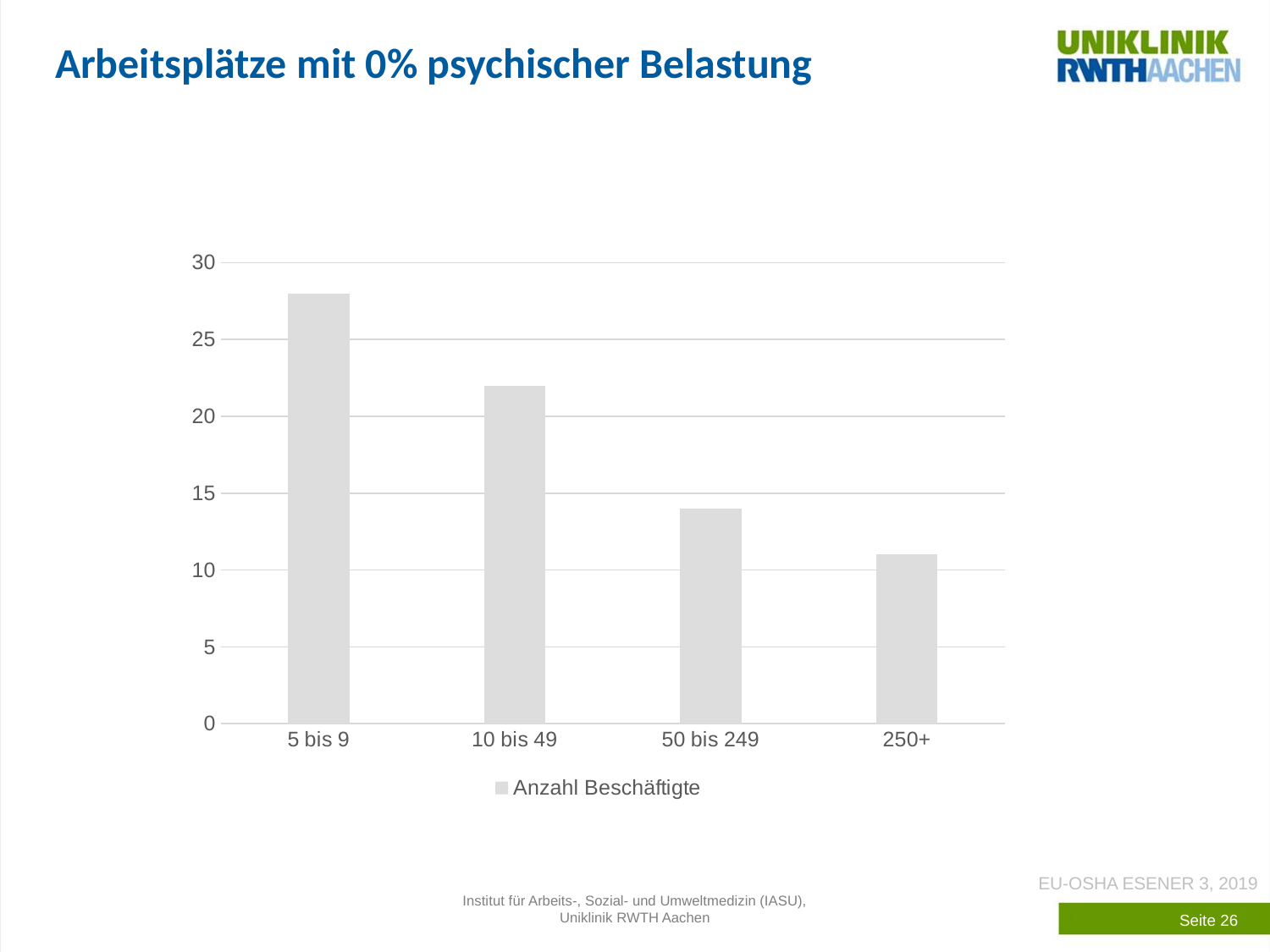
What kind of chart is shown on the slide? bar chart Which category has the highest value? 5 bis 9 Is the value for 10 bis 49 greater or less than 25? less Is the value for 5 bis 9 greater or less than 25? greater Do the values rise or fall from left to right along the x axis? fall Is the value for 50 bis 249 greater or less than 15? less Which is larger, the value for 10 bis 49 or the value for 50 bis 249? 10 bis 49 How many categories are shown on the x axis? 4 What is the legend entry shown below the chart? Anzahl Beschäftigte Which category has the lowest value? 250+